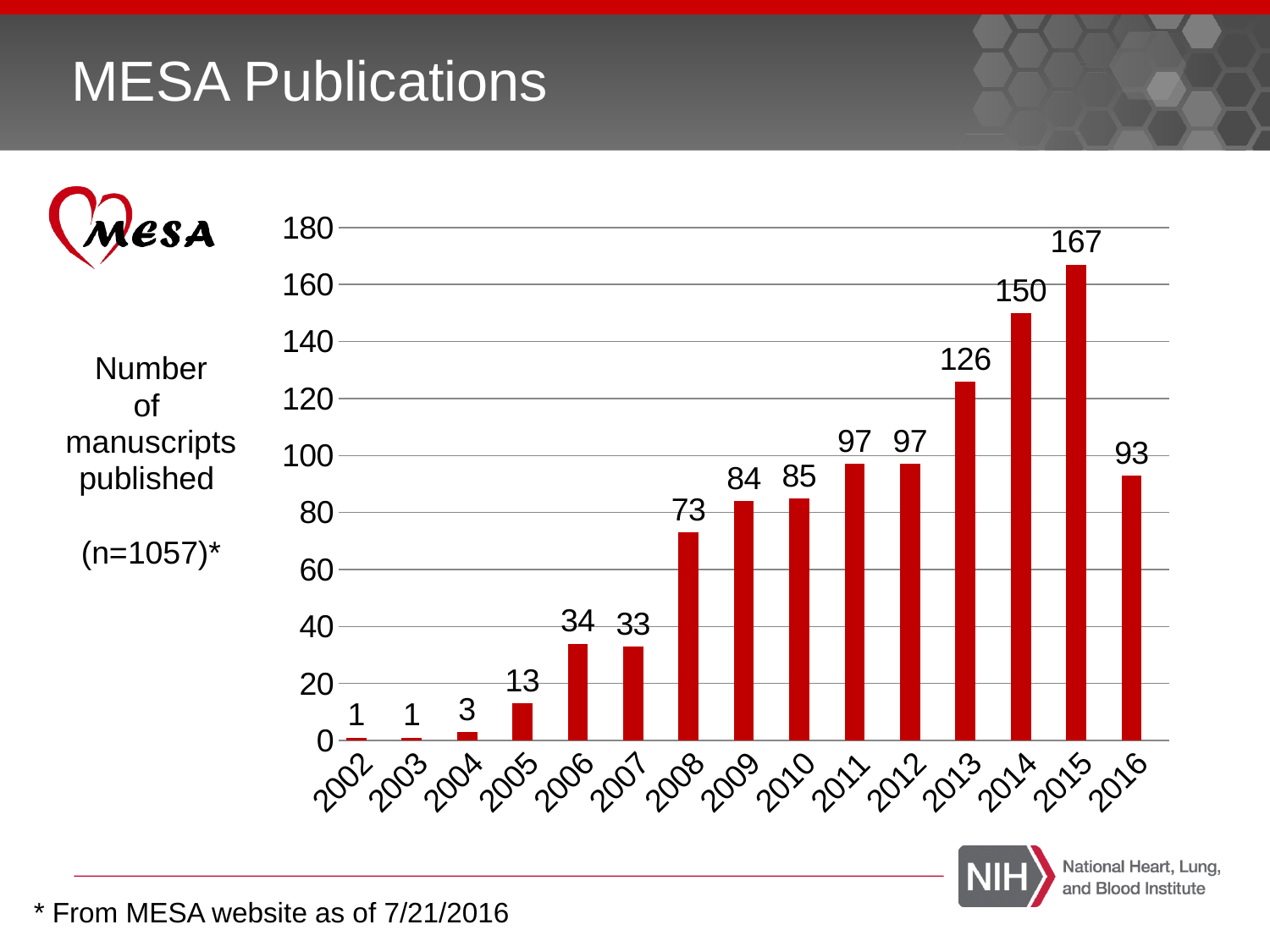
What is the difference between the values for 2015 and 2014? 17 Is the value for 2014 greater or less than 140? greater Which year has the highest number of manuscripts published? 2015 How many years are shown on the x axis? 15 What is the title of the slide containing the chart? MESA Publications How many manuscripts were published in 2015? 167 What is the difference between the values for 2009 and 2010? 1 What is the value shown for 2008? 73 Do the values generally rise or fall from 2002 to 2015? rise Which is larger, the value for 2013 or the value for 2016? 2013 What is the value shown for 2005? 13 What kind of chart is shown on the slide? bar chart